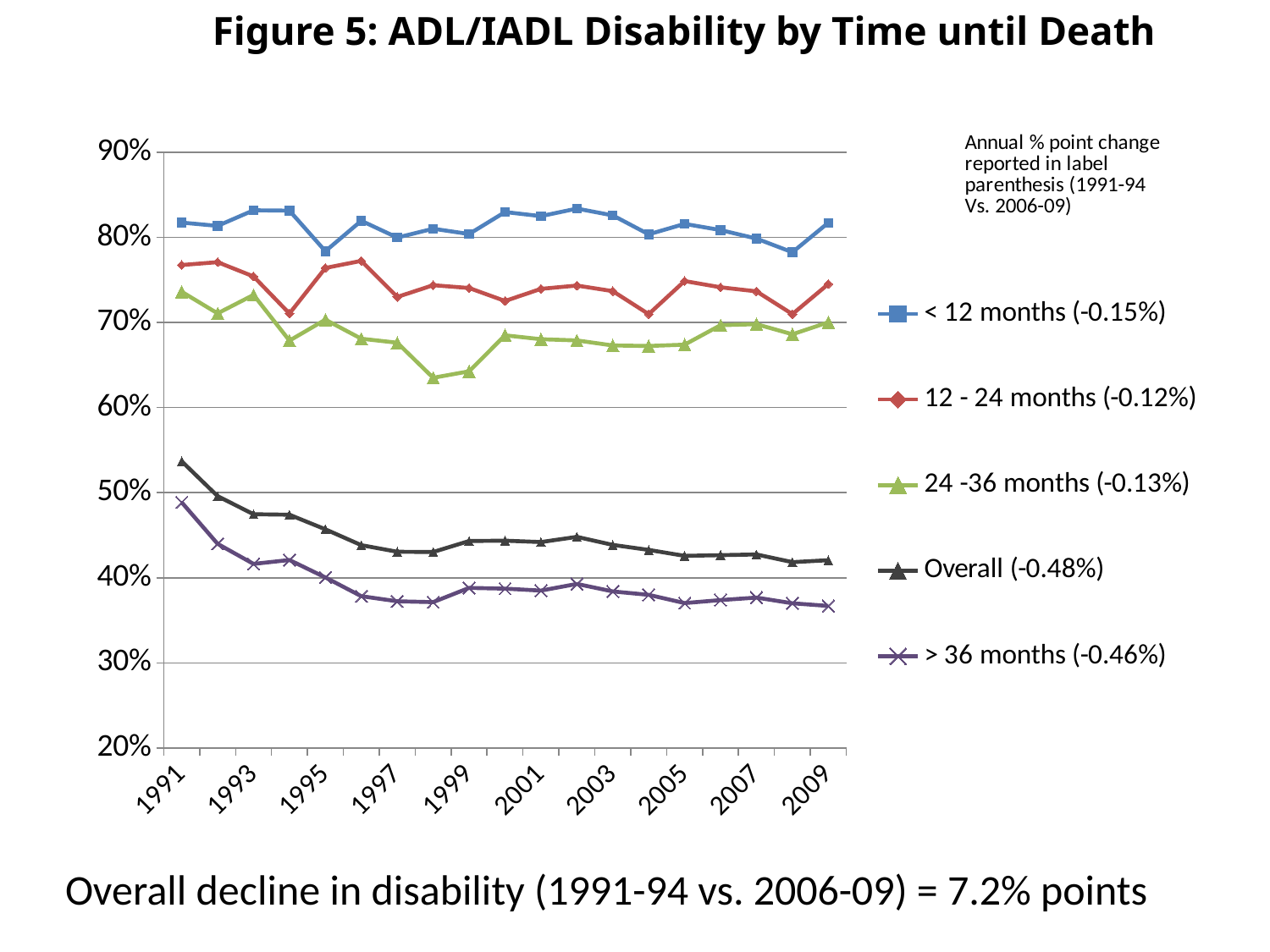
Is the value for Overall in 1991 greater or less than 50%? greater What annual % point change is reported in the legend label for Overall? -0.48% In 1991, which is larger: the value for 12 - 24 months or the value for 24 -36 months? 12 - 24 months Which series has the lowest values across the chart? > 36 months Is the value for < 12 months in 1991 greater or less than 80%? greater Is the value for > 36 months in 2009 greater or less than 40%? less Does the Overall series rise or fall from 1991 to 2009? fall Which series has the highest values across the chart? < 12 months What kind of chart is shown on the slide? line chart How many series does the legend list? 5 What is the title of the chart? Figure 5: ADL/IADL Disability by Time until Death